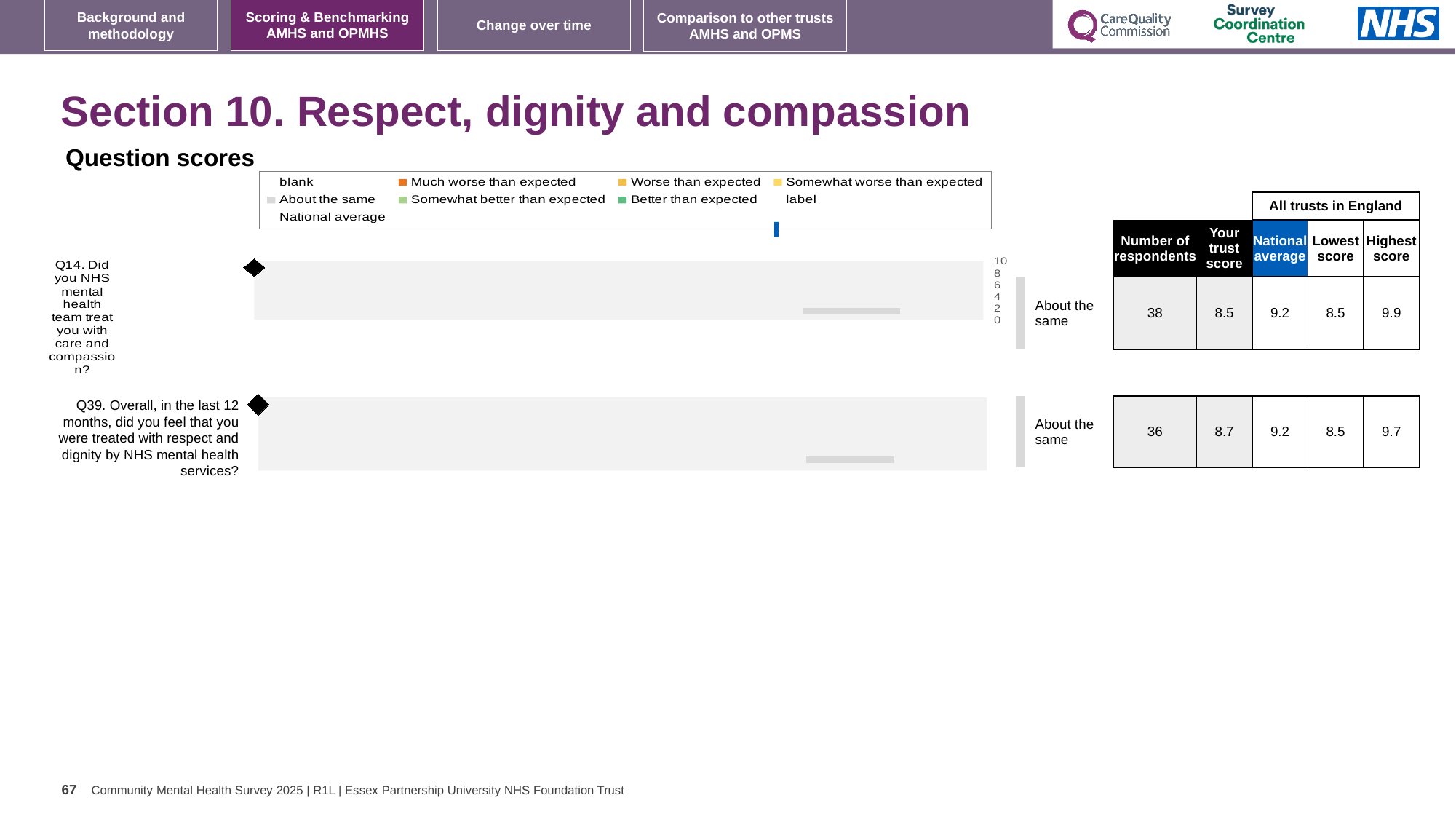
What kind of chart is used to show the question scores on this slide? bar chart What benchmark category is shown for Q14 in the chart? About the same By how much does the national average for Q14 exceed the trust score for Q14? 0.7 What is the trust score for Q39 (respect and dignity)? 8.7 What colour does the legend use for 'Much worse than expected'? orange How many questions are plotted in the question scores chart? 2 What is the highest score among all trusts in England for Q39? 9.7 What is the national average score for Q14? 9.2 Which question has the higher trust score, Q14 or Q39? Q39 What is the trust score for Q14 (care and compassion)? 8.5 How many respondents answered Q14? 38 What is the difference between the highest and lowest trust scores in England for Q39? 1.2